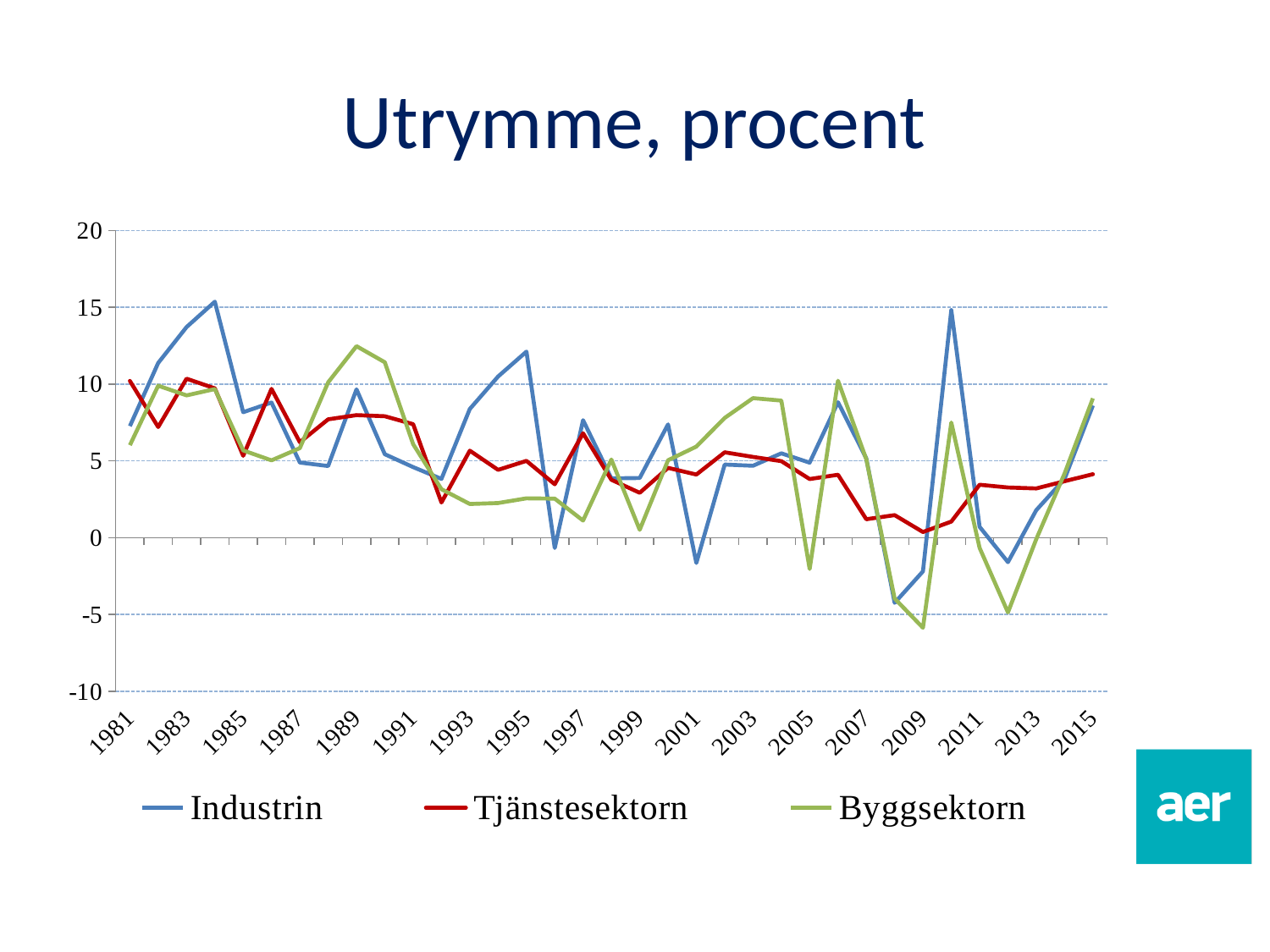
Is the value for Industrin in 2010 greater or less than 10? greater Which series is drawn in red? Tjänstesektorn In 1989, which is larger: Byggsektorn or Industrin? Byggsektorn Which series reaches the highest value anywhere on the chart? Industrin What is the title of the chart? Utrymme, procent Is the value for Byggsektorn in 2009 greater or less than 0? less Which series reaches the lowest value anywhere on the chart? Byggsektorn Is the value for Byggsektorn in 1989 greater or less than 10? greater How many years are labelled on the x axis? 18 How many series does the legend list? 3 Does the Tjänstesektorn series overall rise or fall from 1981 to 2015? fall What kind of chart is shown on the slide? Line chart